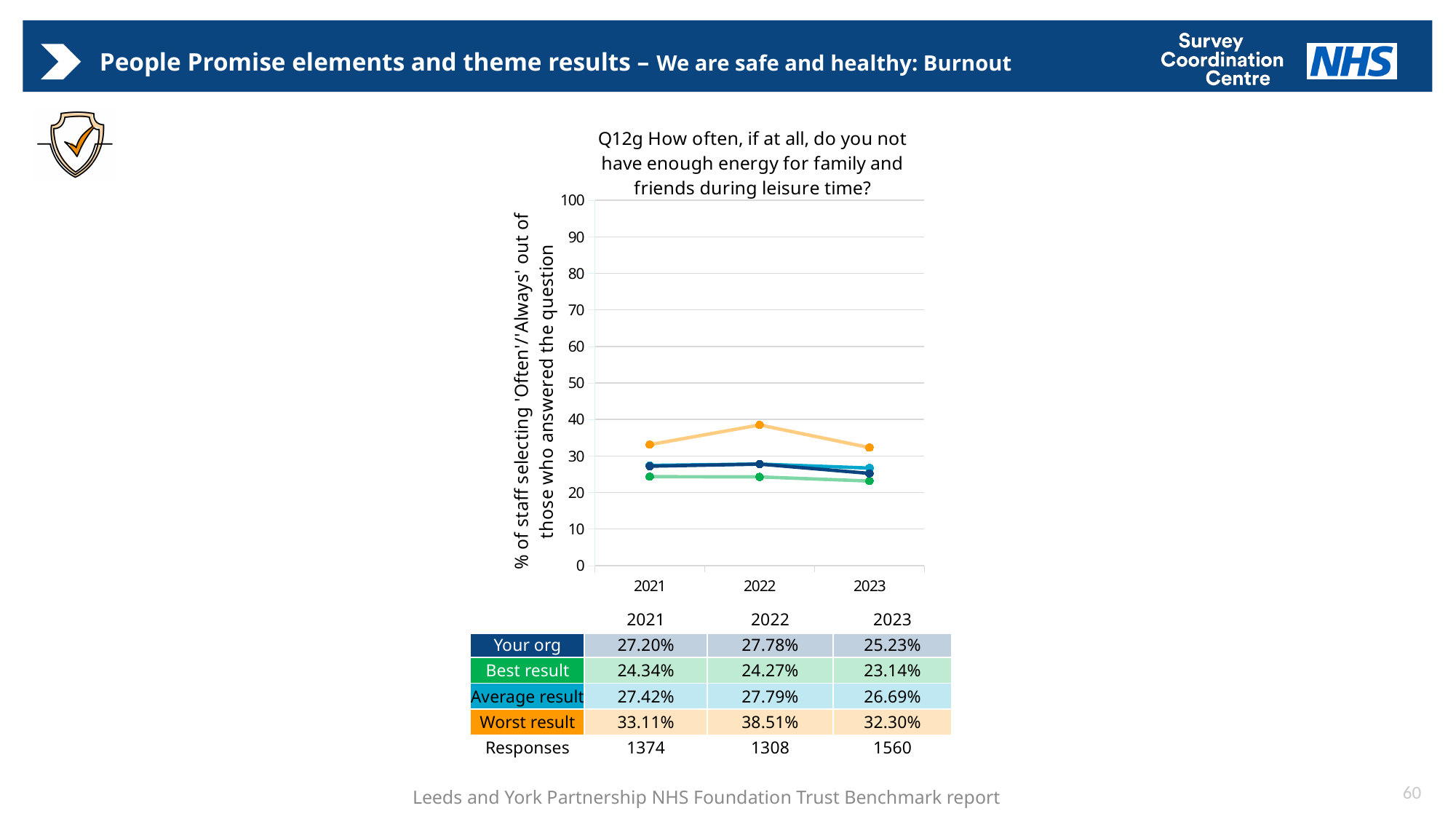
What is the Average result value in 2023? 26.69% Is the Worst result value for 2022 greater or less than 30? greater Which is larger in 2023, the Your org value or the Average result value? Average result How many years are shown on the x axis of the chart? 3 How many series are plotted on the chart? 4 What is the Best result value in 2021? 24.34% In which year is the Worst result value highest? 2022 What is the value for Your org in 2023? 25.23% In which year is the Your org value lowest? 2023 What is the Worst result value in 2022? 38.51% What is the difference between the Worst result and Your org values in 2022? 10.73% What kind of chart is shown on the slide? Line chart